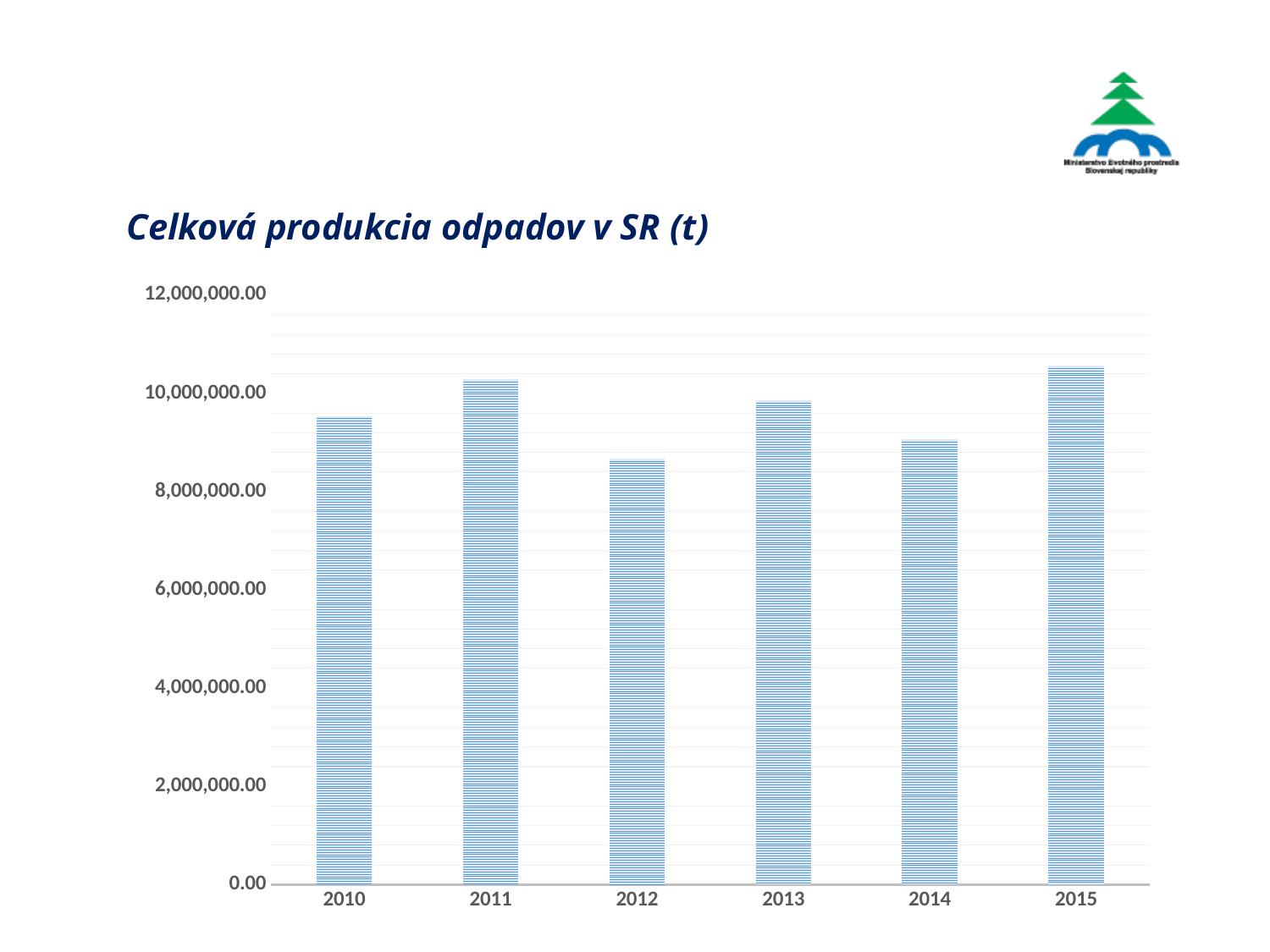
Which year has the lowest total waste production? 2012 What kind of chart is shown on the slide? bar chart What is the title of the chart? Celková produkcia odpadov v SR (t) Is the value for 2014 greater or less than 10,000,000.00? less Which year has the larger value, 2013 or 2014? 2013 Is the value for 2012 greater or less than 8,000,000.00? greater How many years are shown on the x axis of the chart? 6 Does the value rise or fall from 2011 to 2012? fall Is the value for 2011 greater or less than 10,000,000.00? greater Which year has the larger value, 2012 or 2014? 2014 Which year has the highest total waste production? 2015